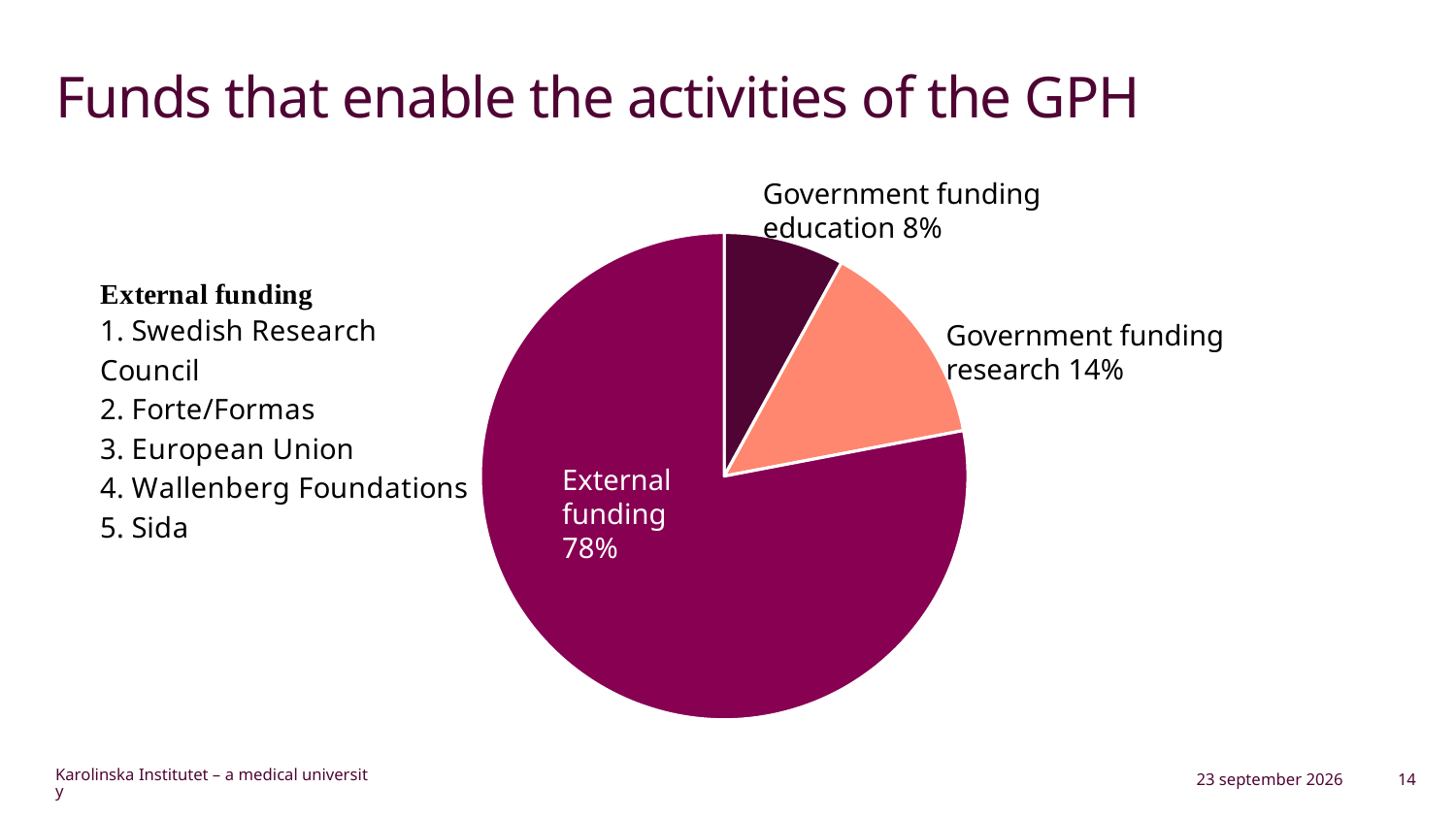
What is the combined share of the two Government funding slices? 22% What is the title of the slide containing the pie chart? Funds that enable the activities of the GPH Which is larger, Government funding research or Government funding education? Government funding research Which slice of the pie is the largest? External funding What is the difference in percentage points between External funding and Government funding research? 64 How many slices does the pie chart have? 3 What is the difference in percentage points between Government funding research and Government funding education? 6 What kind of chart is shown on the slide? pie chart What share of the pie does Government funding research represent? 14% What share of the pie does Government funding education represent? 8% What share of the pie does External funding represent? 78% Which slice of the pie is the smallest? Government funding education